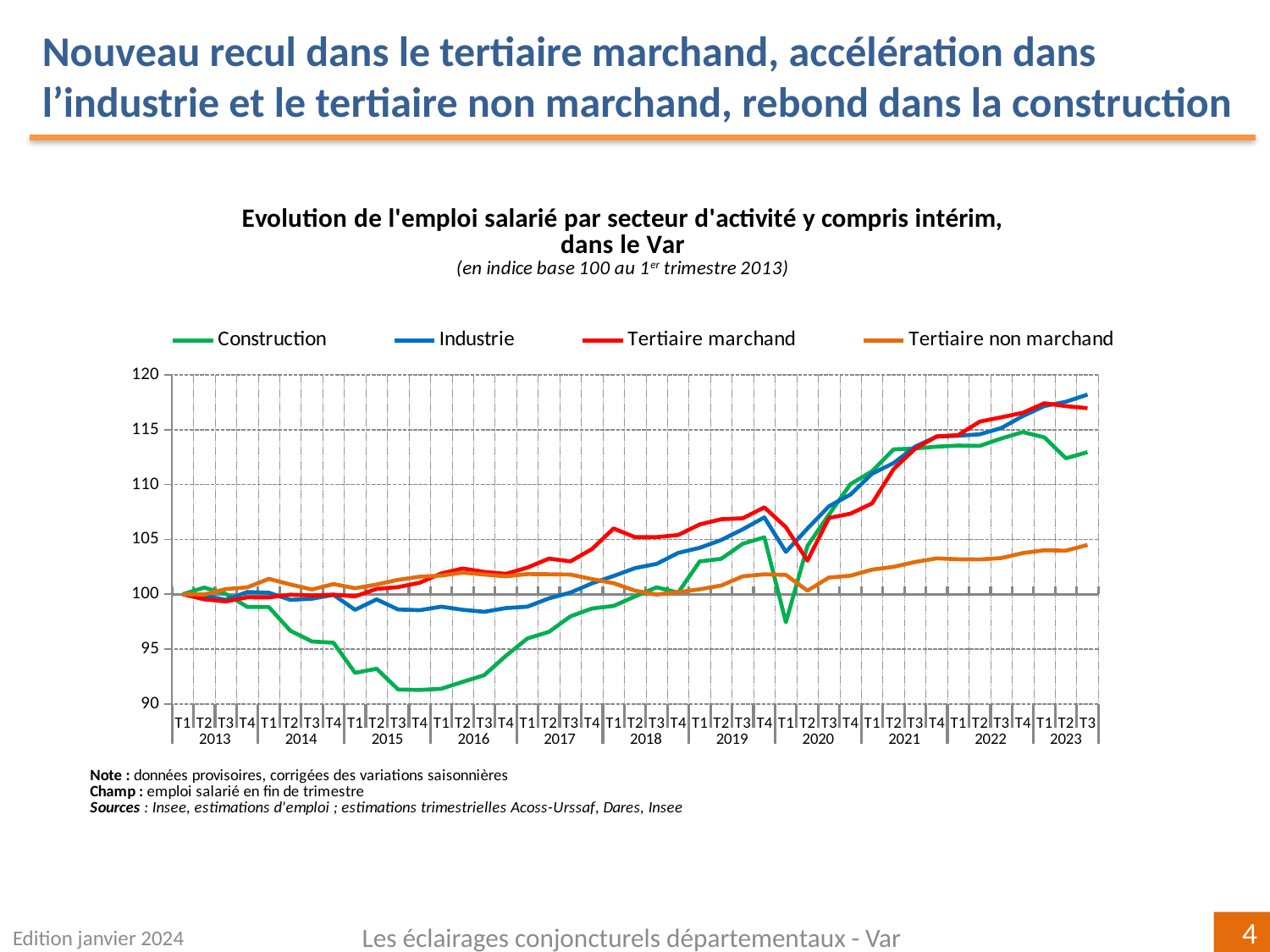
Is the value for Construction at T1 2020 greater or less than 100? less At T1 2020, which is higher: Industrie or Construction? Industrie Is the value for Construction at T4 2015 greater or less than 95? less Which colour is used for the Construction series? green Does the Industrie series rise or fall between T1 2020 and T3 2023? rise Which series is the lowest at T4 2015? Construction Is the value for Industrie at T3 2023 greater or less than 115? greater Which series is the lowest at T3 2023? Tertiaire non marchand How many series does the legend list? 4 What kind of chart is shown on the slide? line chart Does the Construction series rise or fall between T1 2013 and T4 2015? fall